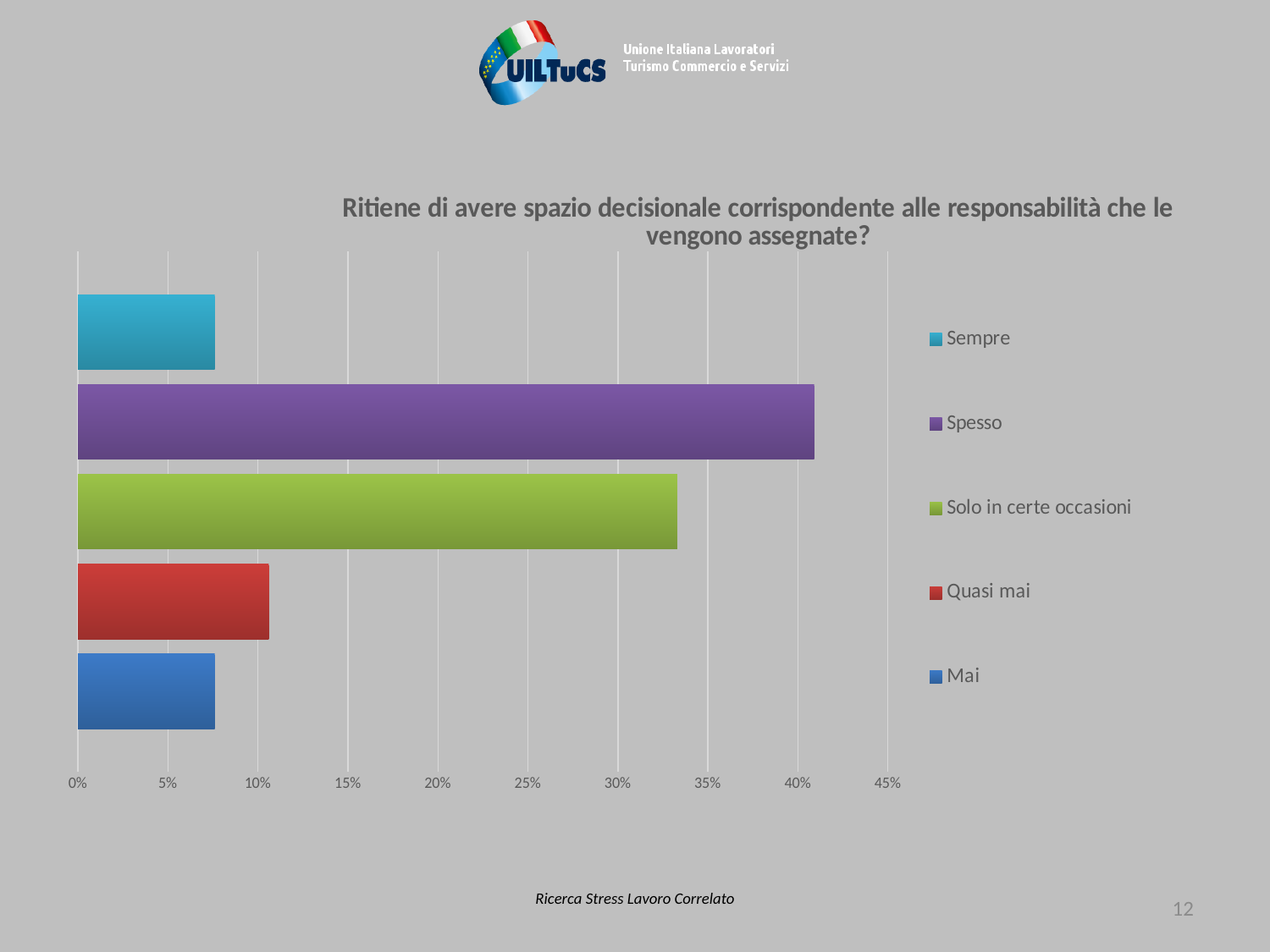
How many series does the legend list? 5 Which is larger, the value for Spesso or the value for Solo in certe occasioni? Spesso Which is larger, the value for Quasi mai or the value for Mai? Quasi mai Which legend entry is shown in purple? Spesso Is the value for Quasi mai greater or less than 15%? less How many bars are plotted in the chart? 5 What kind of chart is shown on the slide? bar chart Is the value for Spesso greater or less than 35%? greater Is the value for Sempre greater or less than 10%? less Which response category has the highest value? Spesso